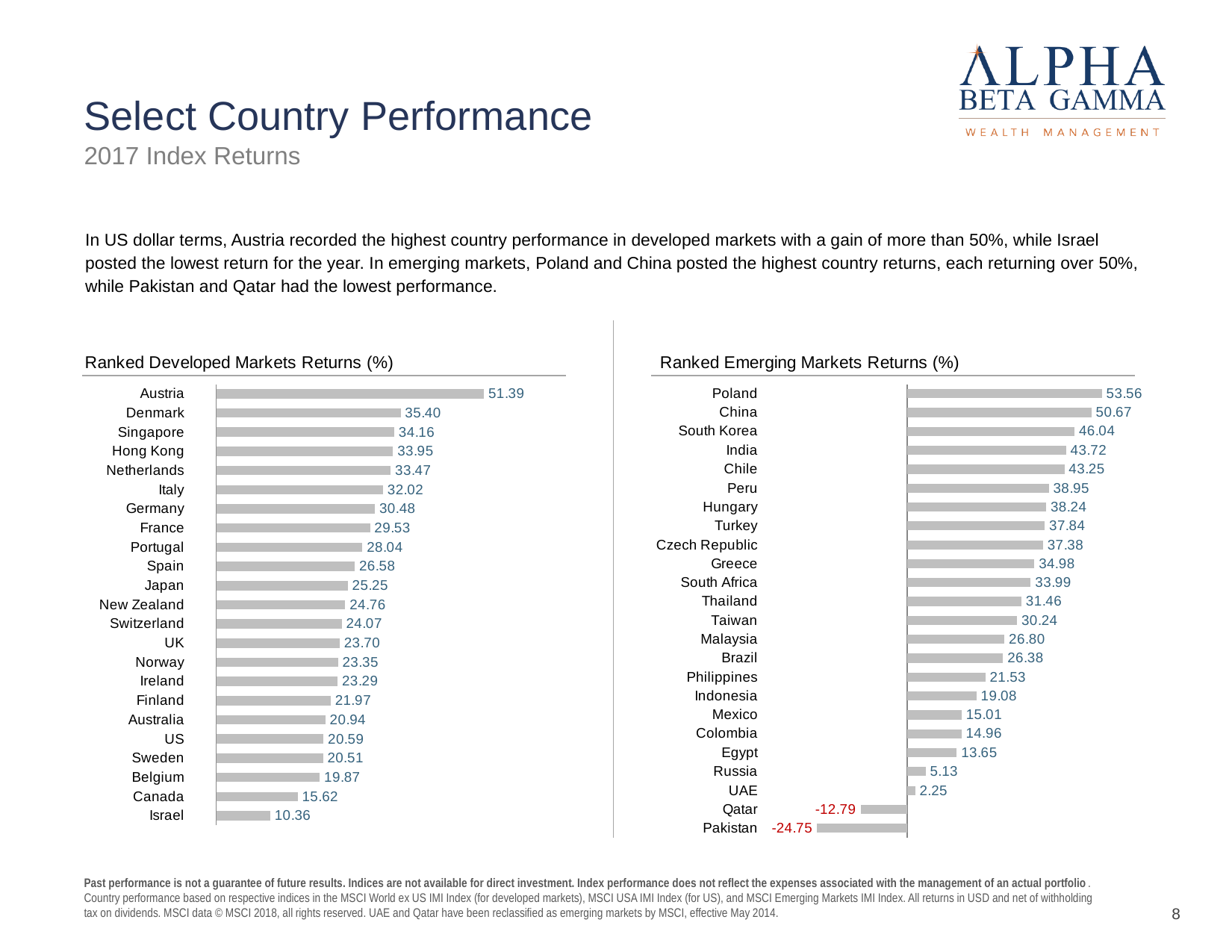
In the Ranked Emerging Markets Returns chart, what is the value for Qatar? -12.79 What kind of chart is the Ranked Emerging Markets Returns chart? Bar chart In the Ranked Emerging Markets Returns chart, which country has the lowest return? Pakistan In the Ranked Emerging Markets Returns chart, which is larger, the value for Mexico or the value for Egypt? Mexico How many countries are shown in the Ranked Developed Markets Returns chart? 23 How many countries are shown in the Ranked Emerging Markets Returns chart? 24 In the Ranked Developed Markets Returns chart, what is the value for Germany? 30.48 In the Ranked Developed Markets Returns chart, which country has the highest return? Austria In the Ranked Emerging Markets Returns chart, what is the difference between the values for Poland and China? 2.89 In the Ranked Developed Markets Returns chart, what is the difference between the values for Austria and Denmark? 15.99 In the Ranked Developed Markets Returns chart, which is larger, the value for Canada or the value for Belgium? Belgium In the Ranked Emerging Markets Returns chart, what is the value for Thailand? 31.46